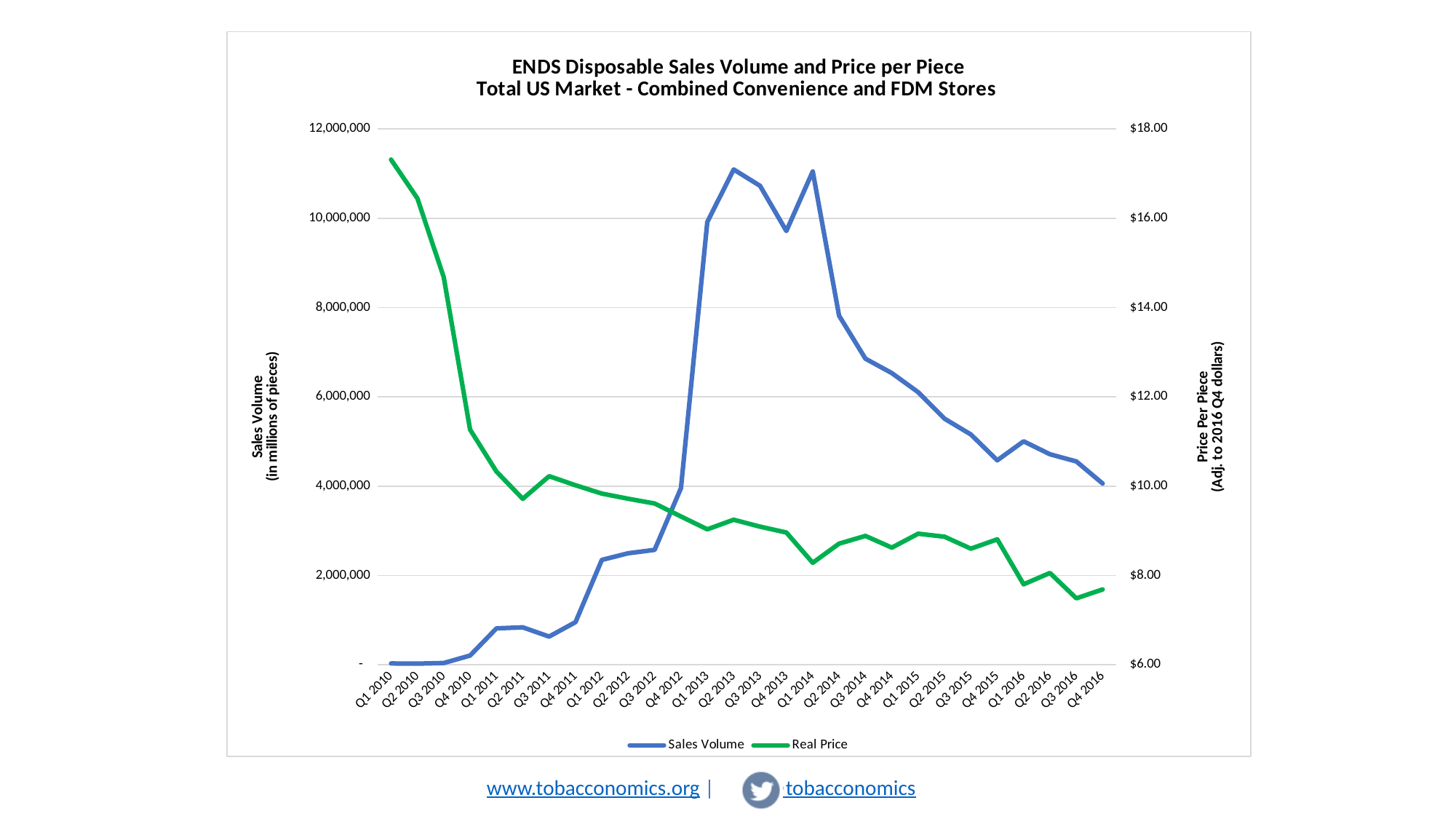
Which series is drawn in green? Real Price Does the Real Price rise or fall overall from Q1 2010 to Q4 2016? Fall Is the Real Price for Q3 2016 greater or less than $8.00? less How many series does the legend list? 2 How many quarters are plotted along the x axis? 28 Is the Real Price for Q1 2010 greater or less than $16.00? greater What kind of chart is shown on the slide? Line chart In which quarter is the Real Price highest? Q1 2010 Is the Sales Volume for Q2 2013 greater or less than 10,000,000? greater What is the label of the right-hand vertical axis? Price Per Piece (Adj. to 2016 Q4 dollars) Which is larger, the Sales Volume in Q2 2013 or in Q4 2016? Q2 2013